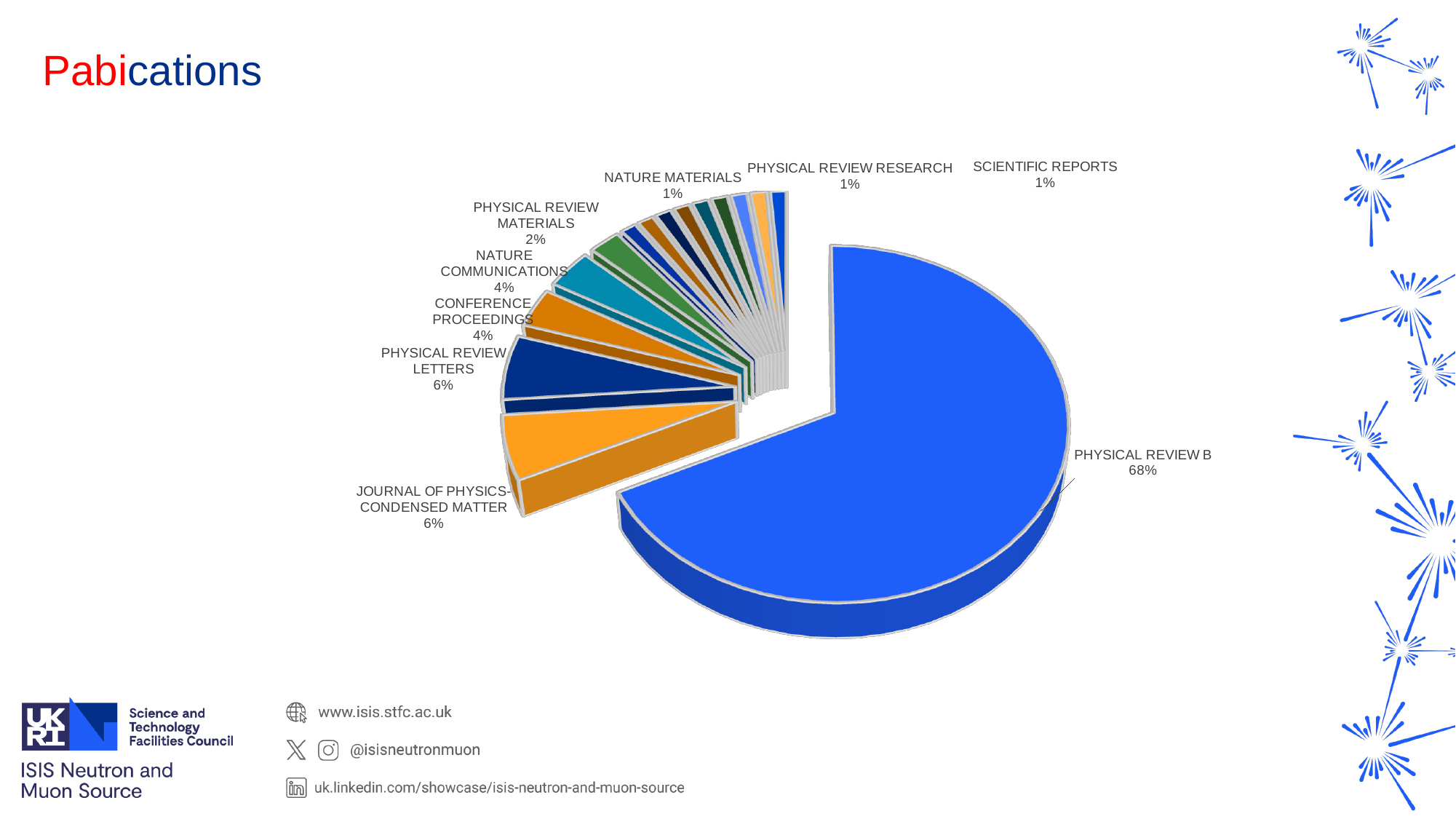
What share of the pie does Physical Review B account for? 68% What percentage is shown for Nature Communications? 4% What percentage is shown for Physical Review Materials? 2% What percentage is shown for Physical Review Letters? 6% What is the difference in percentage points between Physical Review B and Physical Review Letters? 62% Which journal has the largest slice of the pie? Physical Review B What percentage is shown for Journal of Physics-Condensed Matter? 6% What percentage is shown for Scientific Reports? 1% Which is larger, the share for Physical Review Letters or the share for Conference Proceedings? Physical Review Letters What kind of chart is shown on the slide? Pie chart What is the difference in percentage points between Nature Communications and Physical Review Materials? 2% What percentage is shown for Conference Proceedings? 4%